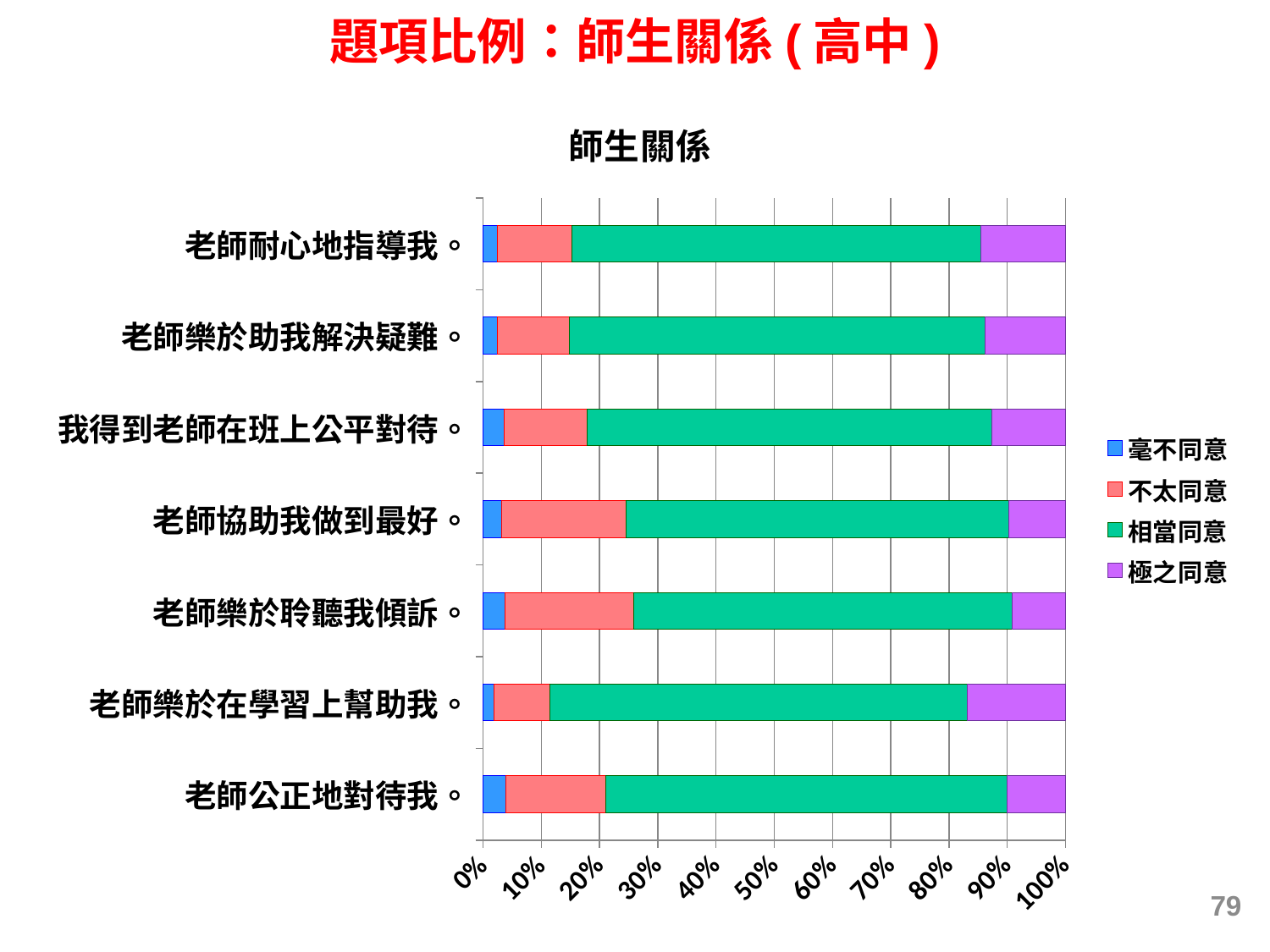
What kind of chart is shown on the slide? Stacked bar chart Is the 相當同意 value for 老師耐心地指導我 greater or less than 60%? greater Is the 極之同意 value for 老師樂於在學習上幫助我 greater or less than 10%? greater Is the 毫不同意 value for 老師公正地對待我 greater or less than 10%? less How many statements (categories) are plotted in the chart? 7 What is the title of the chart? 師生關係 Which has the larger 不太同意 share: 老師樂於聆聽我傾訴 or 老師樂於在學習上幫助我? 老師樂於聆聽我傾訴 Which has the larger 極之同意 share: 老師樂於在學習上幫助我 or 老師樂於聆聽我傾訴? 老師樂於在學習上幫助我 Which colour represents 相當同意 in the chart? Green How many series does the legend list? 4